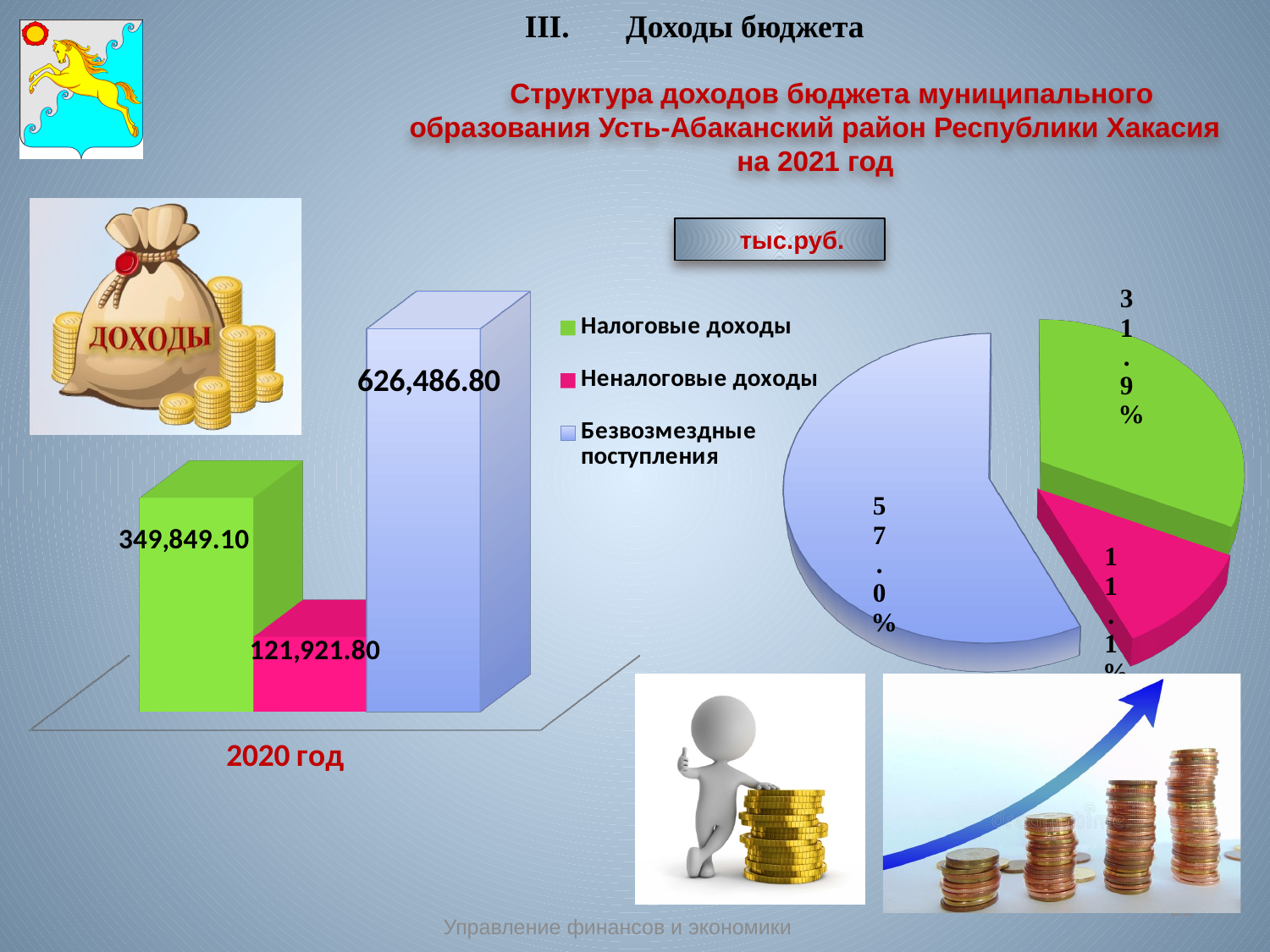
In the bar chart, what is the difference between Безвозмездные поступления and Налоговые доходы? 276,637.70 In the bar chart, what is the value for Безвозмездные поступления? 626,486.80 In the bar chart, which series has the highest value? Безвозмездные поступления In the pie chart, what share does the blue slice (Безвозмездные поступления) have? 57.0% In the bar chart, what is the value for Налоговые доходы? 349,849.10 What kind of chart is shown on the left of the slide? bar chart How many series does the legend list? 3 What year label appears under the bar chart? 2020 год In the bar chart, what is the value for Неналоговые доходы? 121,921.80 In the bar chart, which series has the lowest value? Неналоговые доходы In the bar chart, which is larger: Налоговые доходы or Неналоговые доходы? Налоговые доходы In the pie chart, what share does the green slice (Налоговые доходы) have? 31.9%